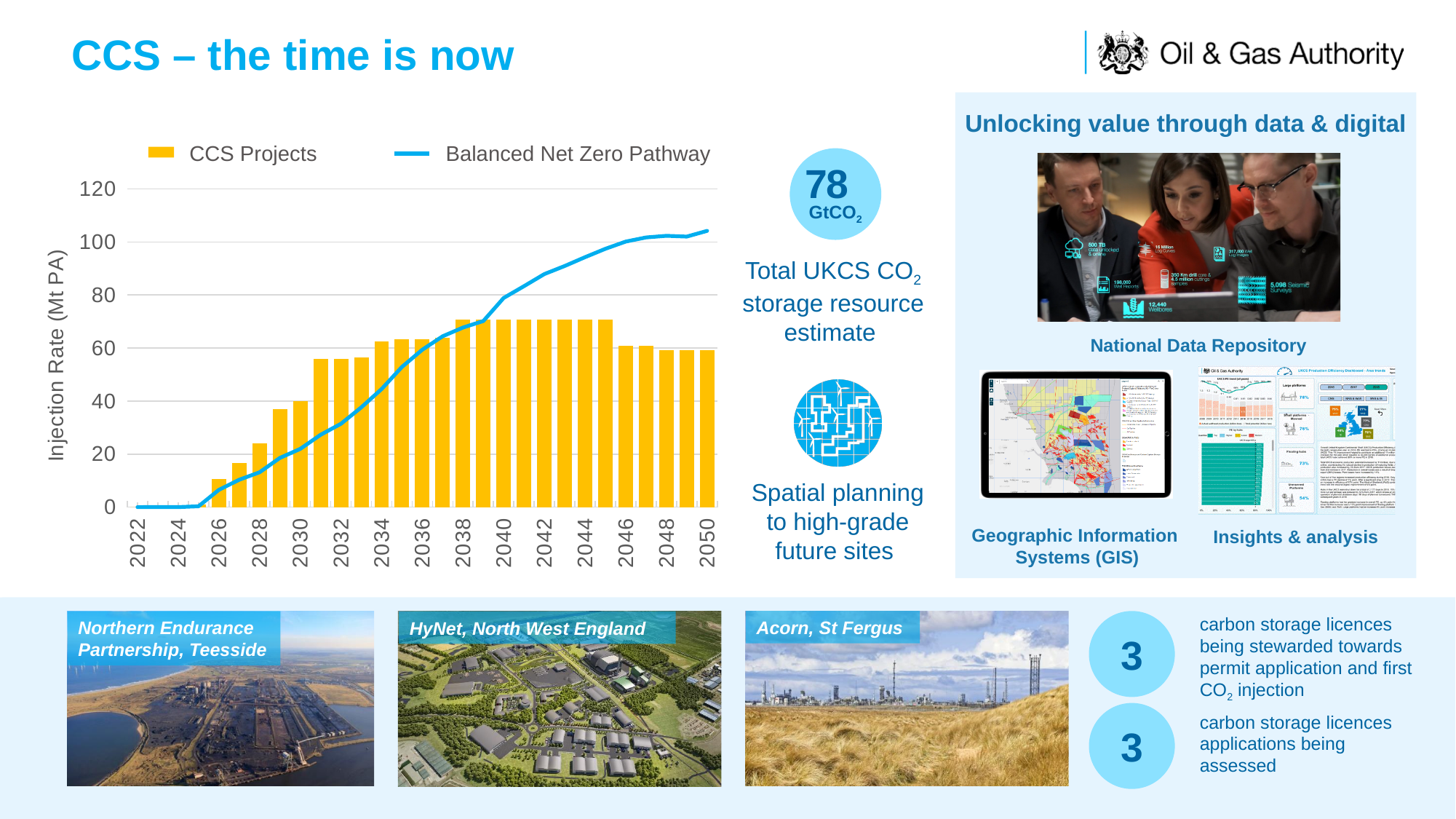
In which year does the Balanced Net Zero Pathway reach its highest value? 2050 Is the Balanced Net Zero Pathway value for 2050 greater or less than 100? greater Does the Balanced Net Zero Pathway line rise or fall from 2022 to 2050? rise What are the two series named in the chart legend? CCS Projects and Balanced Net Zero Pathway What is the label on the vertical axis of the chart? Injection Rate (Mt PA) How many series does the chart legend list? 2 What kind of chart is shown on the left of the slide? A bar chart combined with a line Is the CCS Projects value for 2030 greater or less than 60? less In 2032, which is larger: the CCS Projects value or the Balanced Net Zero Pathway value? CCS Projects Is the CCS Projects value for 2040 greater or less than 60? greater In 2050, which is larger: the CCS Projects value or the Balanced Net Zero Pathway value? Balanced Net Zero Pathway